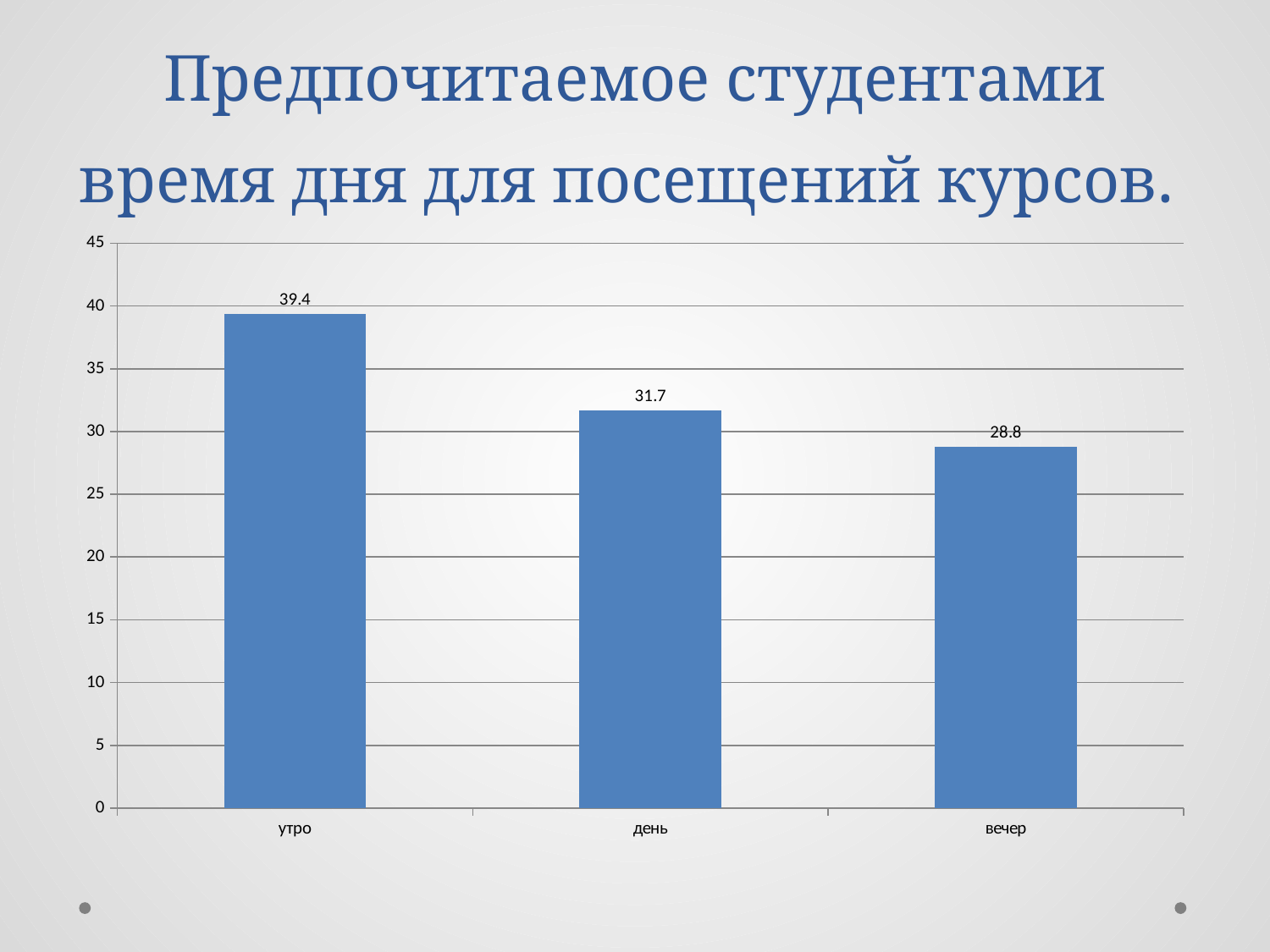
What is the difference between the values for утро and вечер? 10.6 What kind of chart is shown on the slide? bar chart Do the values rise or fall from утро to вечер along the x axis? fall Which is larger, the value for день or the value for вечер? день Which category has the highest value? утро Is the value for вечер greater or less than 30? less What is the value for день? 31.7 What is the value for вечер? 28.8 Which category has the lowest value? вечер What is the value for утро? 39.4 How many categories are shown on the x axis? 3 What is the difference between the values for утро and день? 7.7